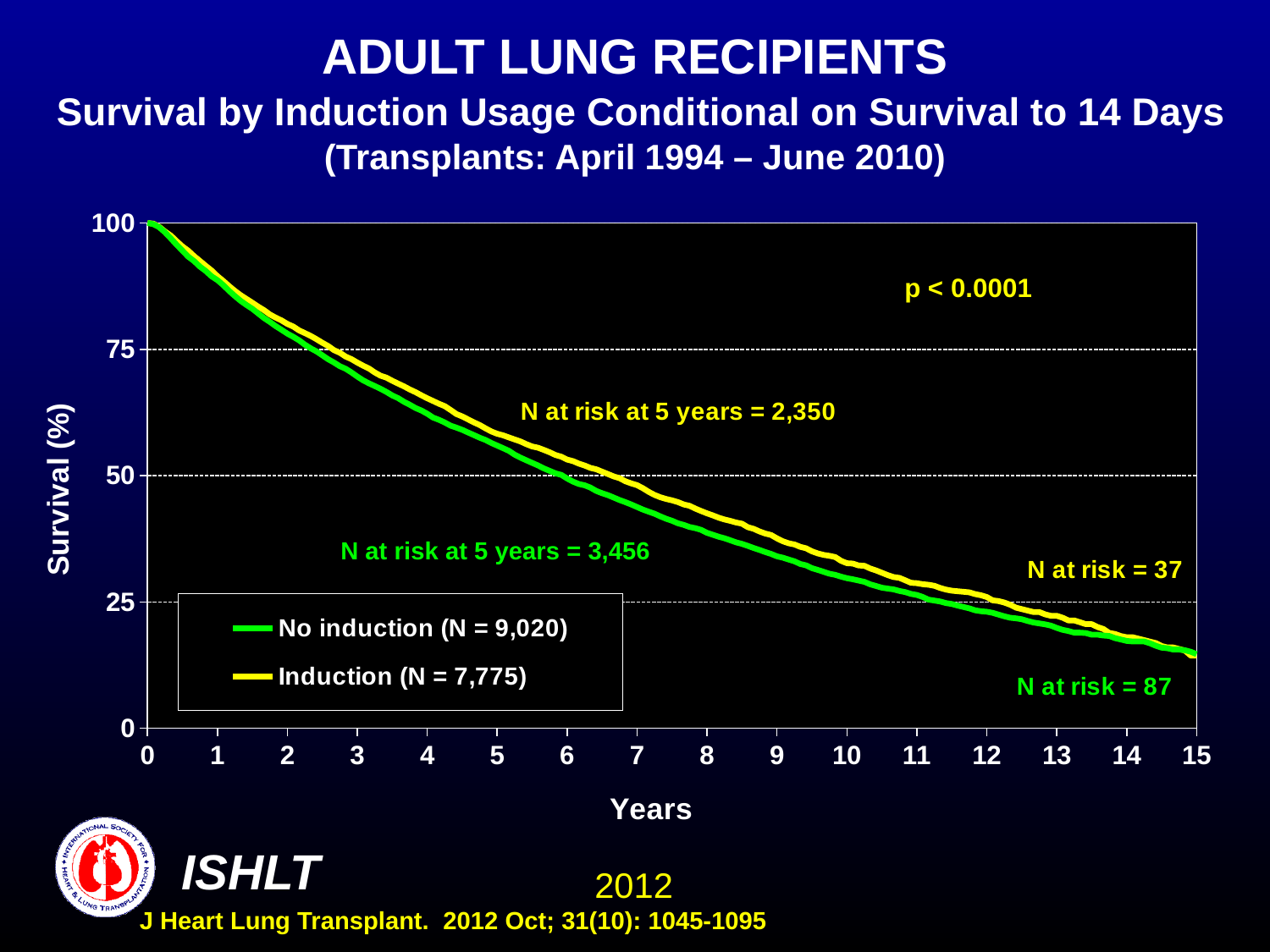
Is the survival for the Induction group at 1 year greater or less than 75? greater Do the survival curves rise or fall as years increase? Fall What is the N for the Induction group shown in the legend? 7,775 How many series does the legend list? 2 What colour is the line for the Induction group? Yellow What is the N for the No induction group shown in the legend? 9,020 What is the N at risk at 5 years for the No induction group (green annotation)? 3,456 What kind of chart is shown on the slide? Line chart What p-value is shown on the chart? p < 0.0001 What is the N at risk at 5 years for the Induction group (yellow annotation)? 2,350 At 5 years, which group has the higher survival, Induction or No induction? Induction Is the survival for the No induction group at 10 years greater or less than 50? less